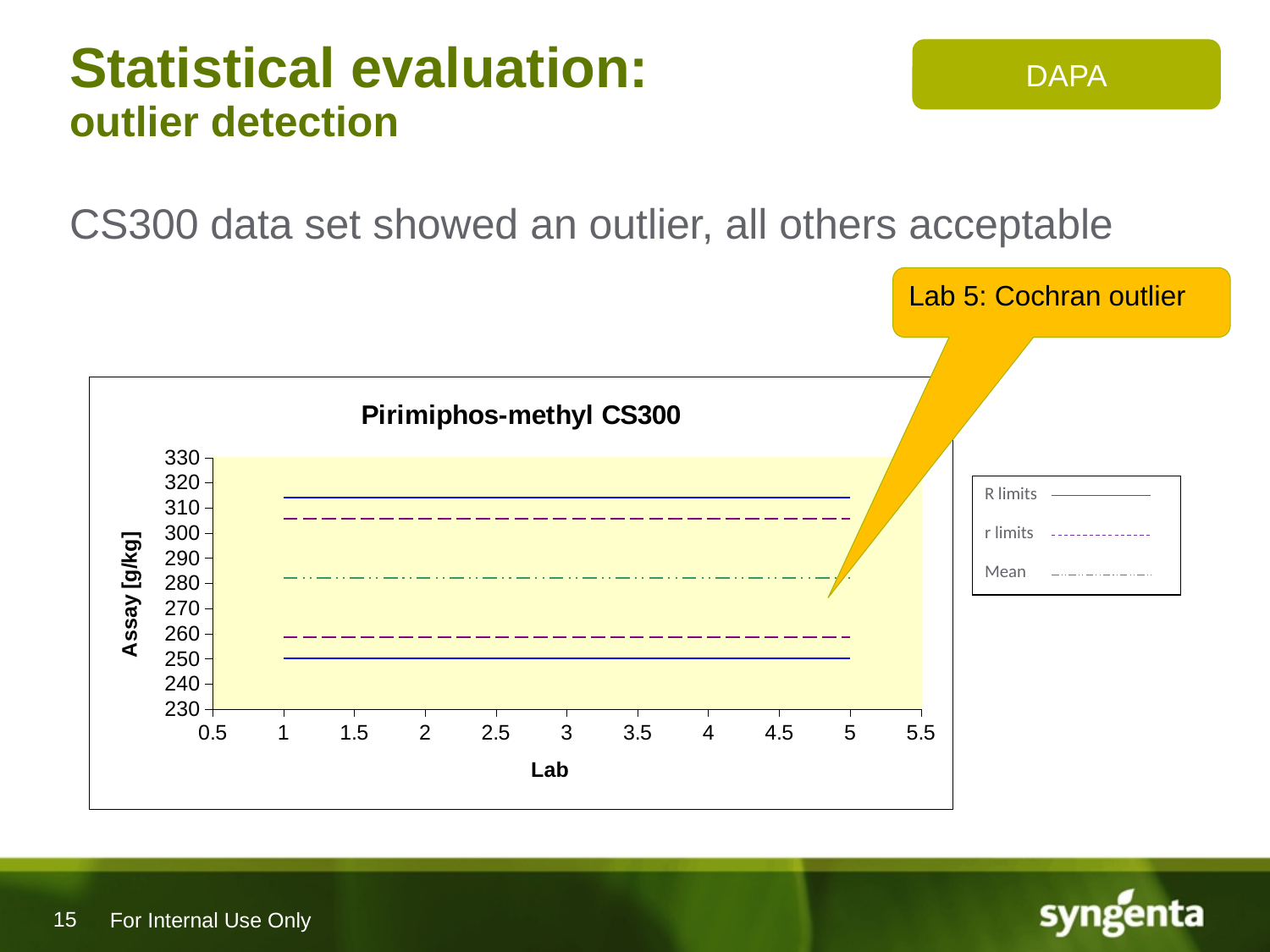
How many series does the chart legend list? 3 Is the lower R limits line greater or less than 260 g/kg? less Which is higher on the chart, the upper R limits line or the upper r limits line? upper R limits line What kind of chart is shown on the slide? line chart What is the label of the y axis of the chart? Assay [g/kg] Is the Mean line greater or less than 290 g/kg? less Is the upper R limits line greater or less than 310 g/kg? greater What is the title of the chart? Pirimiphos-methyl CS300 Does the Mean line rise, fall or stay flat across the x axis? stays flat What is the highest value shown on the y axis of the chart? 330